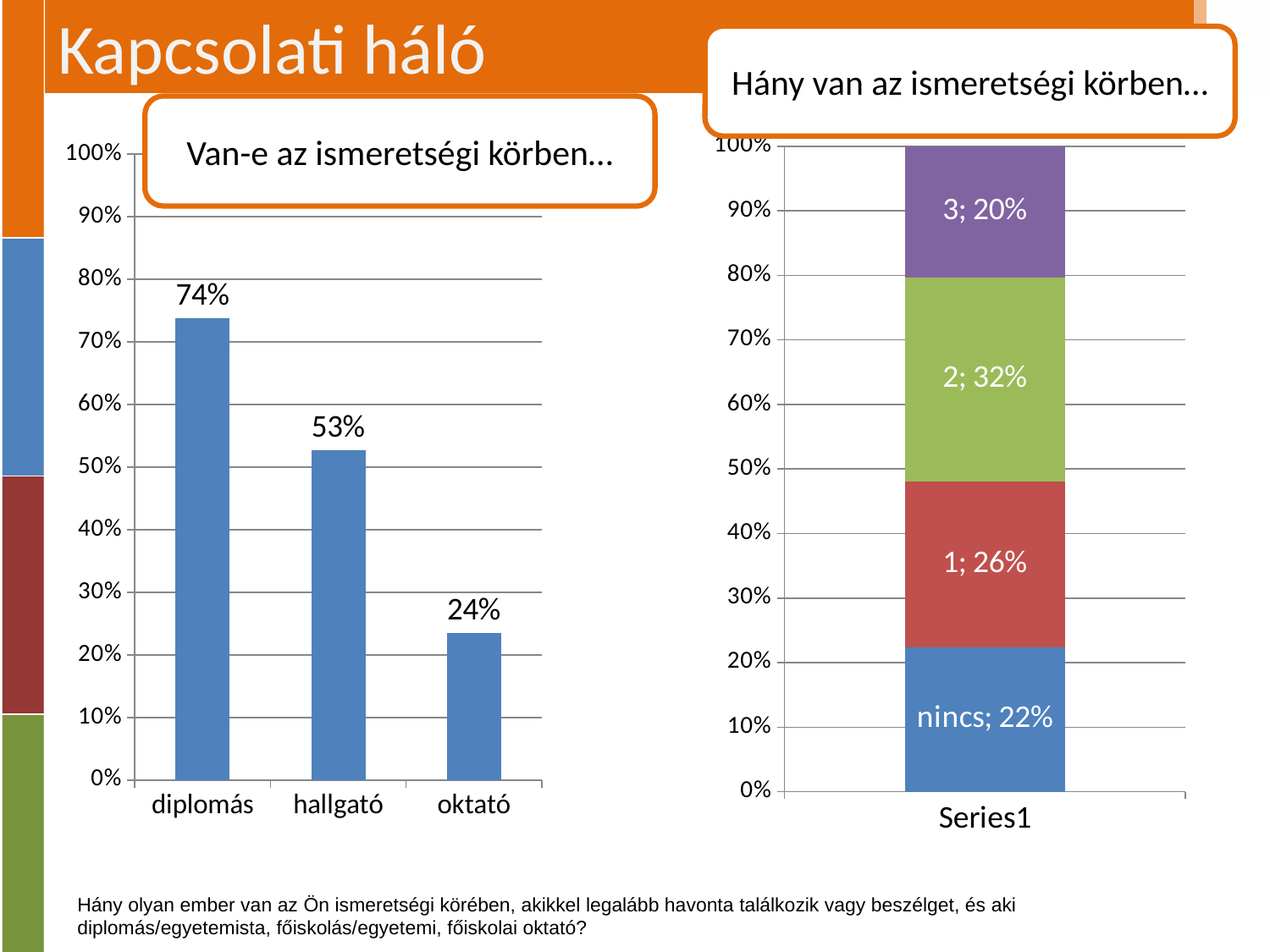
In the left chart (Van-e az ismeretségi körben…), which category has the highest value? diplomás In the right chart (Hány van az ismeretségi körben…), what is the total of the stacked bar? 100% In the left chart (Van-e az ismeretségi körben…), do the values rise or fall from left to right? fall In the right chart (Hány van az ismeretségi körben…), what is the value of the segment labelled 2? 32% In the left chart (Van-e az ismeretségi körben…), what is the difference between the values for diplomás and hallgató? 21% What kind of chart is the right chart (Hány van az ismeretségi körben…)? stacked bar chart In the left chart (Van-e az ismeretségi körben…), what is the value for diplomás? 74% In the left chart (Van-e az ismeretségi körben…), how many categories are shown on the x axis? 3 In the right chart (Hány van az ismeretségi körben…), what is the value of the segment labelled nincs? 22% In the left chart (Van-e az ismeretségi körben…), what is the value for oktató? 24% In the right chart (Hány van az ismeretségi körben…), which segment is the largest? 2 In the left chart (Van-e az ismeretségi körben…), which category has the lowest value? oktató